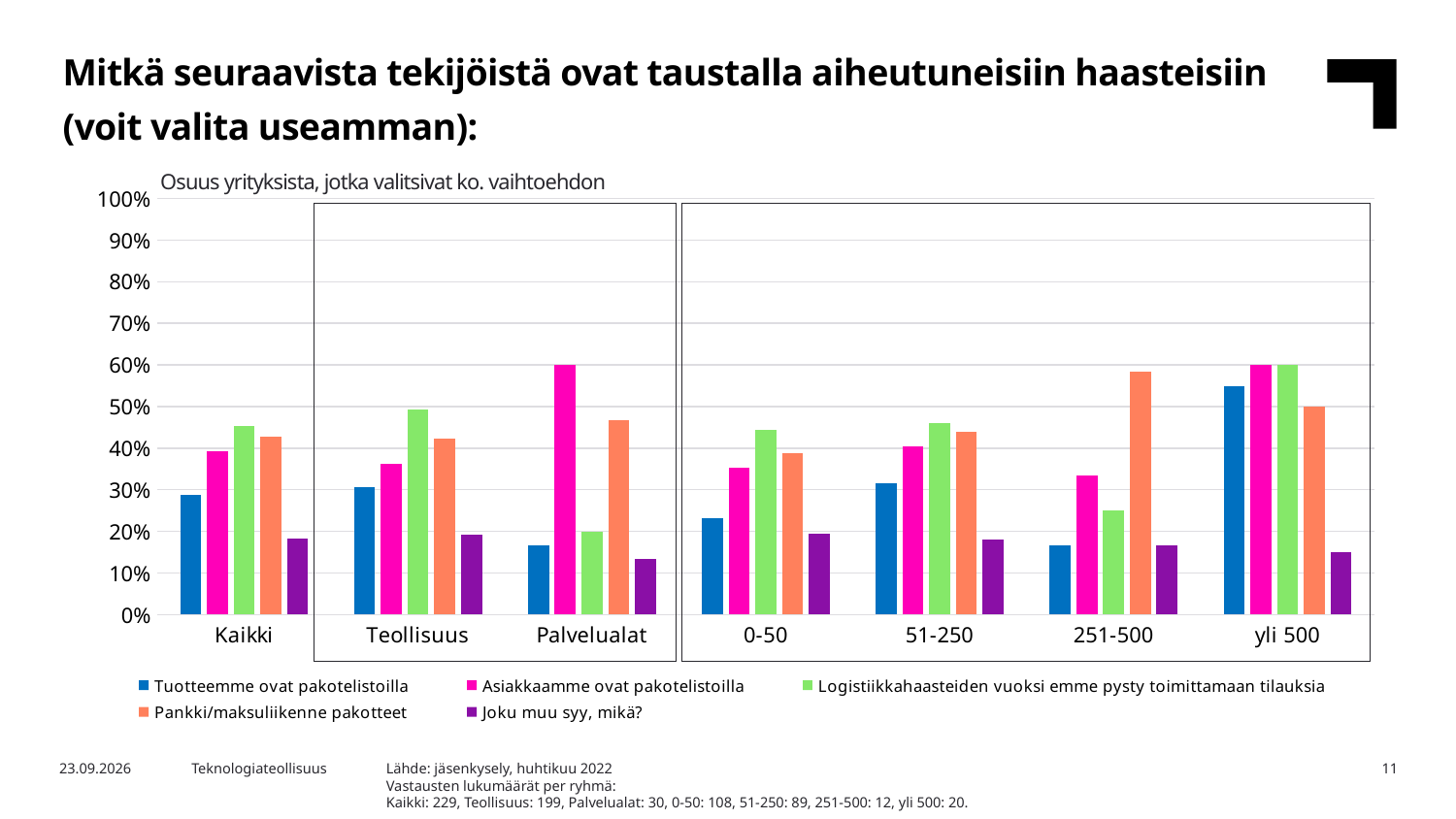
Is the value for Tuotteemme ovat pakotelistoilla in the Kaikki category greater or less than 40%? less What is the label shown above the chart's y axis? Osuus yrityksista, jotka valitsivat ko. vaihtoehdon Which series has the highest value in the Teollisuus category? Logistiikkahaasteiden vuoksi emme pysty toimittamaan tilauksia How many categories are shown on the x axis? 7 Which series has the lowest value in the Palvelualat category? Joku muu syy, mikä? How many series does the legend list? 5 Is the value for Asiakkaamme ovat pakotelistoilla in the Palvelualat category greater or less than 50%? greater Is the value for Tuotteemme ovat pakotelistoilla in the yli 500 category greater or less than 50%? greater What kind of chart is shown on the slide? bar chart Which category has the highest value for Pankki/maksuliikenne pakotteet? 251-500 In the 251-500 category, which is larger: Asiakkaamme ovat pakotelistoilla or Logistiikkahaasteiden vuoksi emme pysty toimittamaan tilauksia? Asiakkaamme ovat pakotelistoilla